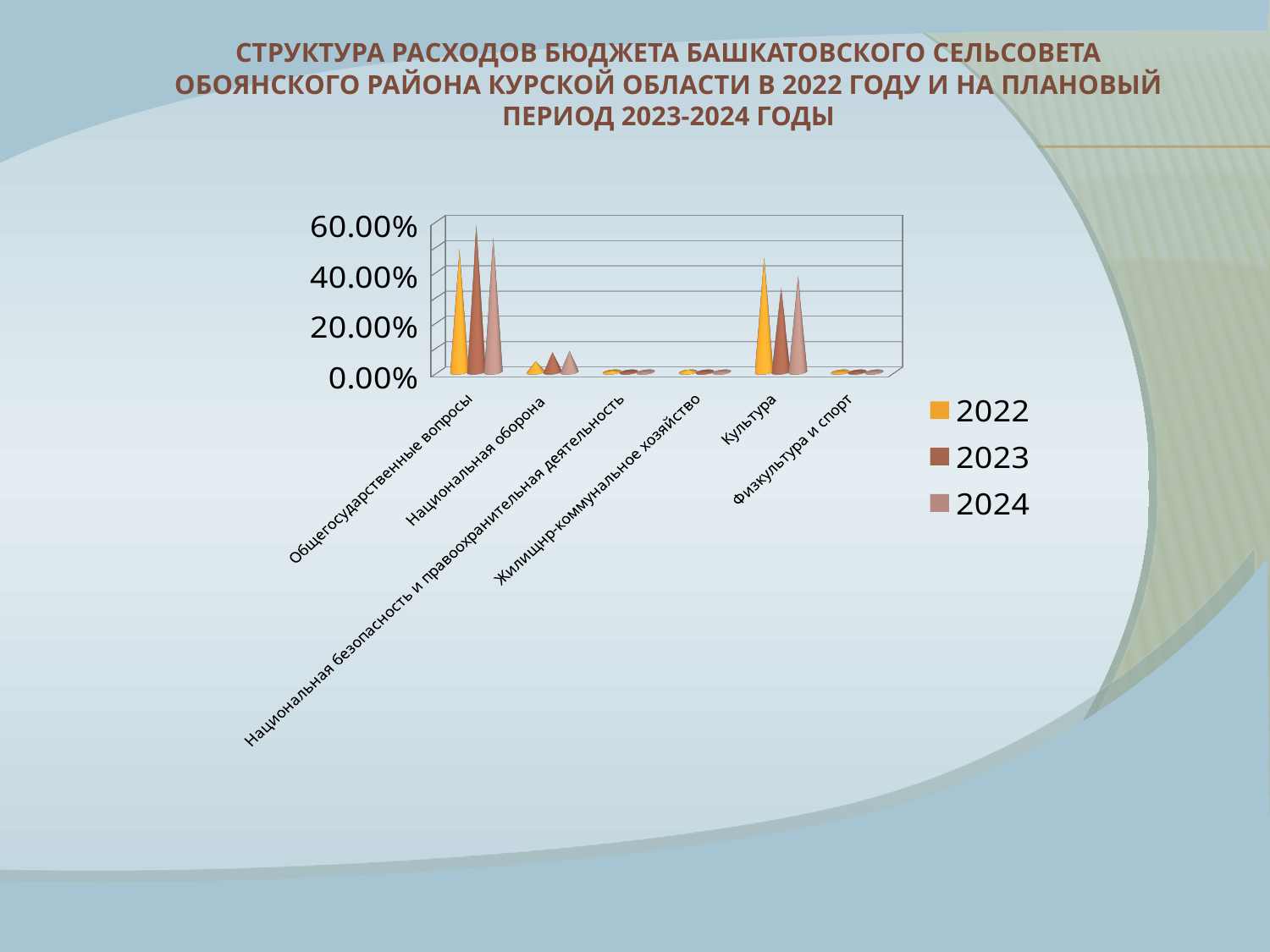
Which category has the highest value for 2022? Общегосударственные вопросы How many expenditure categories are shown on the x axis of the chart? 6 Which category has the highest value for 2023? Общегосударственные вопросы Is the 2022 value for Культура greater or less than 20.00%? greater For Культура, which year has the larger value: 2022 or 2023? 2022 Is the 2023 value for Общегосударственные вопросы greater or less than 40.00%? greater How many series does the chart legend list? 3 Is the 2022 value for Национальная оборона greater or less than 20.00%? less Which years are listed in the chart legend? 2022, 2023, 2024 For Общегосударственные вопросы, which year has the larger value: 2022 or 2023? 2023 What kind of chart is shown on the slide? bar chart